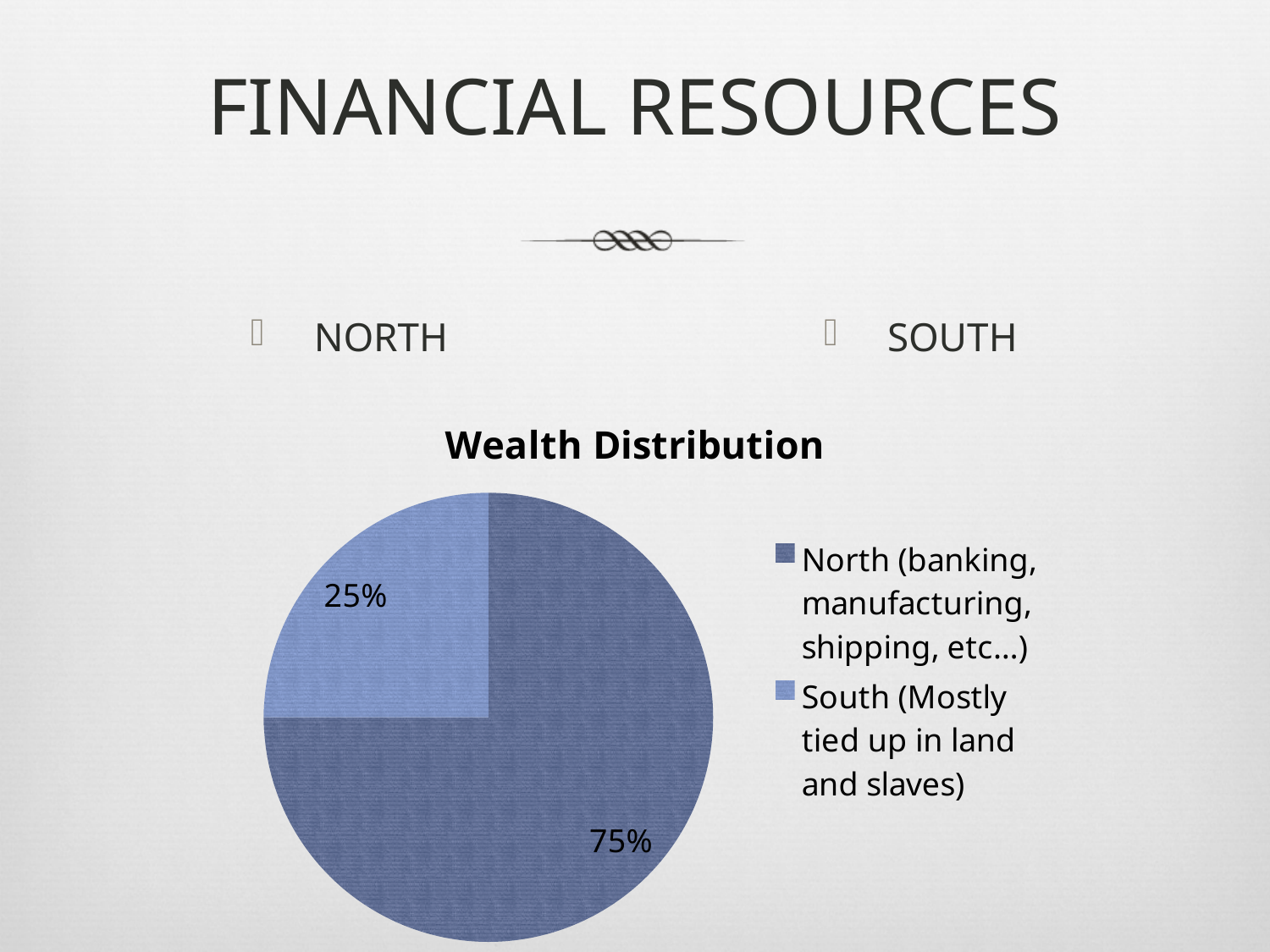
How many entries does the legend list? 2 Which slice of the pie is the largest? North (banking, manufacturing, shipping, etc...) What share of the pie does the North slice represent? 75% Is the South slice greater or less than 50% of the pie? less What kind of chart is shown on the slide? pie chart Which is larger, the North slice or the South slice? North What is the title of the chart? Wealth Distribution What is the difference in percentage points between the North and South slices? 50 How many slices does the pie chart have? 2 What share of the pie does the South slice represent? 25% Which legend entry is shown in the lighter blue colour? South (Mostly tied up in land and slaves) Which slice of the pie is the smallest? South (Mostly tied up in land and slaves)